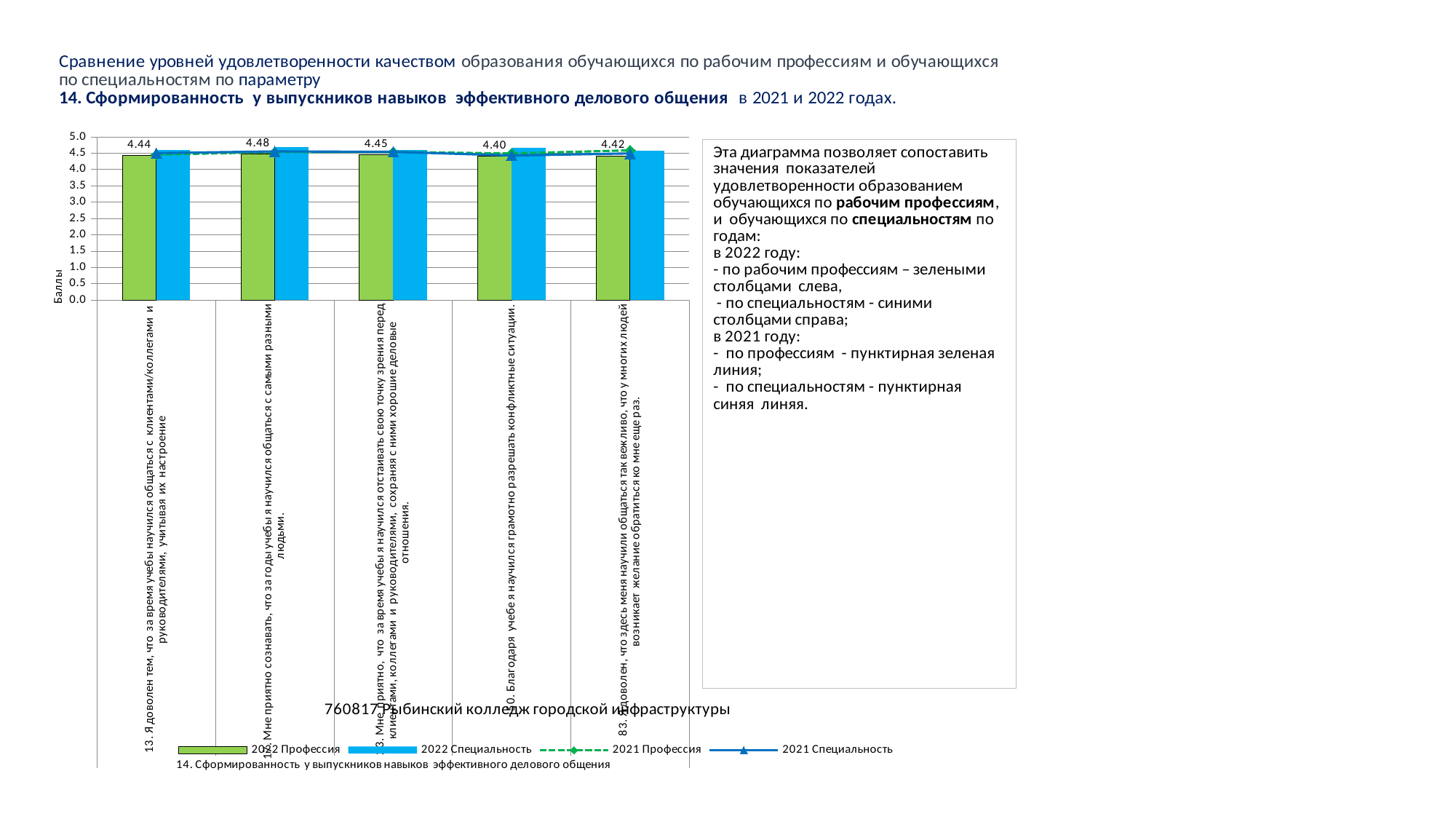
What kind of chart is shown on the slide? A combined bar and line chart What is the 2022 Профессия value for the category "83. Я доволен, что здесь меня научили общаться так вежливо, что у многих людей возникает желание обратиться ко мне еще раз"? 4.42 How many series does the chart legend list? 4 Which category has the lowest labelled 2022 Профессия value? Благодаря учебе я научился грамотно разрешать конфликтные ситуации (4.40) What is the 2022 Профессия value for the category "13. Я доволен тем, что за время учебы научился общаться с клиентами/коллегами и руководителями, учитывая их настроение"? 4.44 Is the 2022 Специальность value for the first category greater or less than 4.0? greater Which is larger: the 2022 Профессия value for the first category (4.44) or for the second category (4.48)? The second category (4.48) What is the label of the vertical axis of the chart? Баллы What is the 2022 Профессия value for the category "Благодаря учебе я научился грамотно разрешать конфликтные ситуации"? 4.40 How many categories are shown on the x axis of the chart? 5 What is the difference between the highest (4.48) and lowest (4.40) labelled 2022 Профессия values? 0.08 Which category has the highest labelled 2022 Профессия value? Мне приятно сознавать, что за годы учебы я научился общаться с самыми разными людьми (4.48)